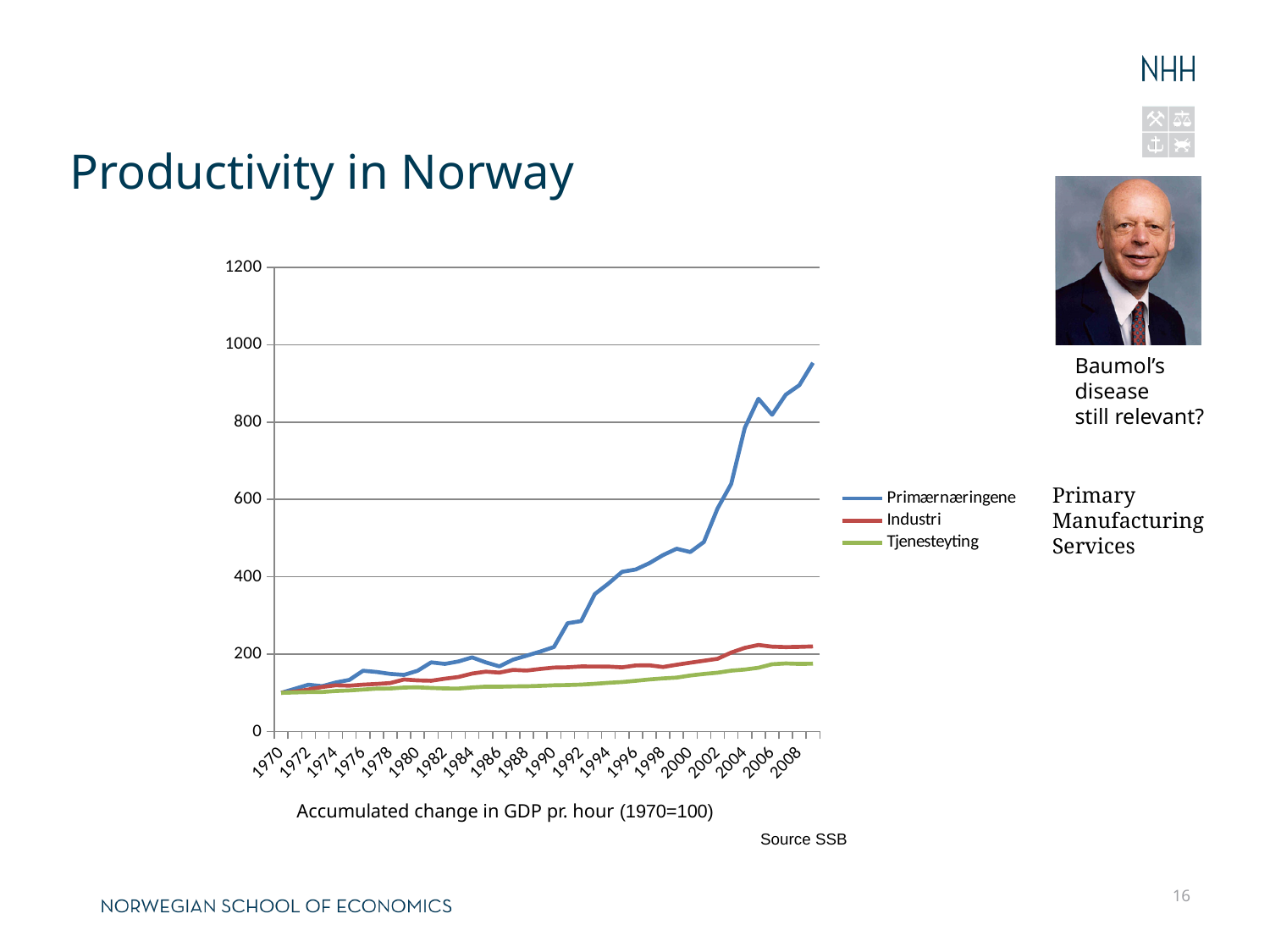
How many year labels are shown on the x axis? 20 What is the highest value shown on the y axis? 1200 Is the value for Primærnæringene in 1990 greater or less than 400? less Does the Primærnæringene series rise or fall from 1970 to 2008? rise Is the value for Primærnæringene in 2008 greater or less than 800? greater What kind of chart is shown on the slide? line chart In 2000, which is larger: Industri or Tjenesteyting? Industri How many series does the legend list? 3 Is the value for Industri in 2008 greater or less than 400? less Which series has the highest value in 2008? Primærnæringene What are the three series named in the legend? Primærnæringene, Industri, Tjenesteyting Which series has the lowest value in 2008? Tjenesteyting